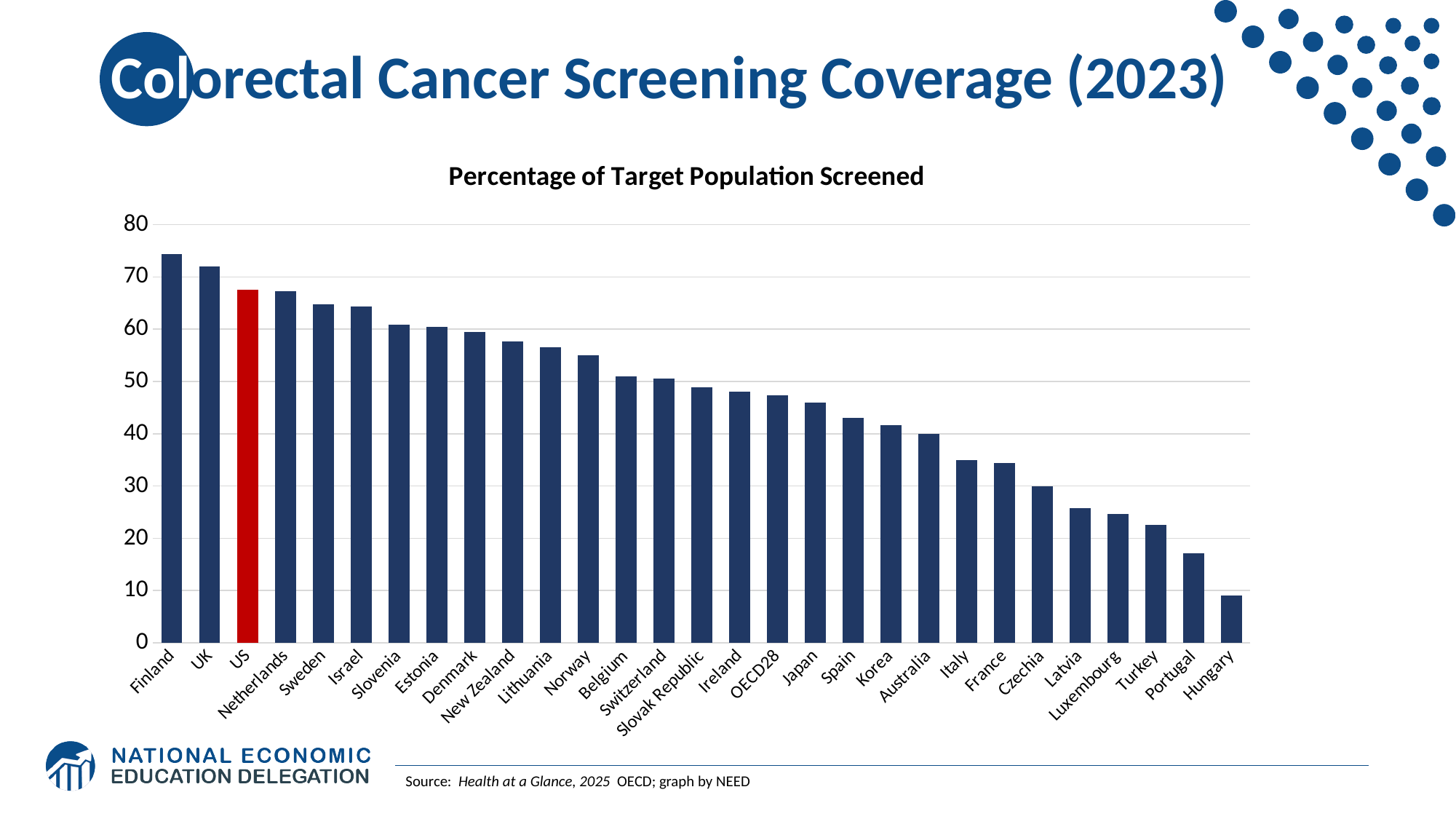
Is the value for the US greater or less than 60? greater Which bar is coloured red rather than dark blue? US How many categories (bars) are plotted on the chart? 29 Is the value for Japan greater or less than 40? greater Which has a higher value, Norway or Spain? Norway Is the value for Finland greater or less than 70? greater Which country has the lowest percentage of target population screened? Hungary What kind of chart is shown on the slide? bar chart Do the values rise or fall moving from left to right along the x axis? fall Which country has the highest percentage of target population screened? Finland